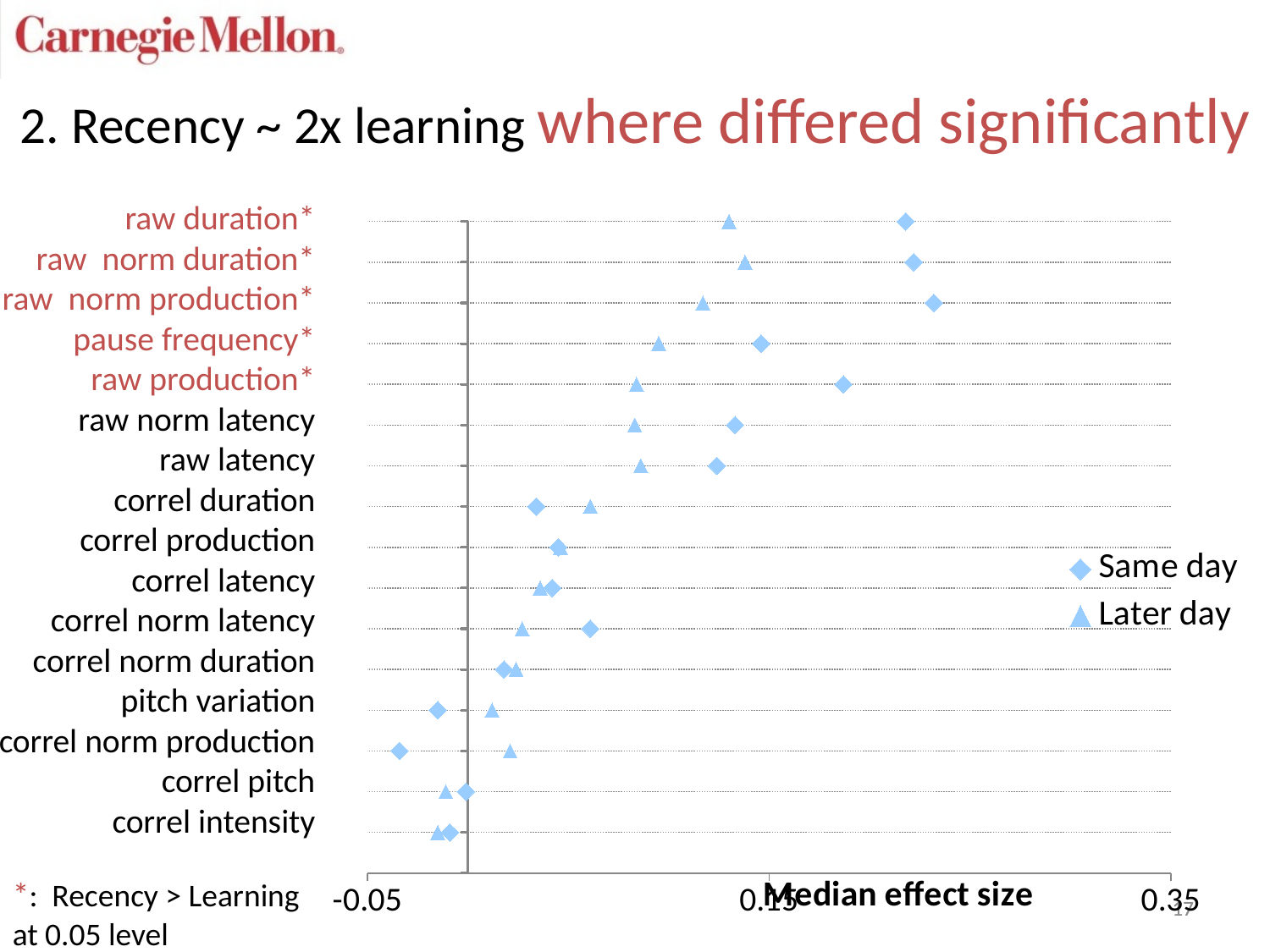
Is the Same day value for raw norm production greater or less than 0.15? greater How many categories are listed on the vertical axis of the chart? 16 For pitch variation, which series has the larger median effect size, Same day or Later day? Later day For raw duration, which series has the larger median effect size, Same day or Later day? Same day How many series does the legend list? 2 For correl duration, which series has the larger median effect size, Same day or Later day? Later day Which category has the lowest Same day median effect size? correl norm production What kind of chart is shown on the slide? Scatter chart Is the Later day value for raw duration greater or less than 0.15? less Is the Same day value for correl norm production greater or less than -0.05? greater What is the title of the horizontal axis? Median effect size Which marker shape represents the Later day series in the legend? Triangle